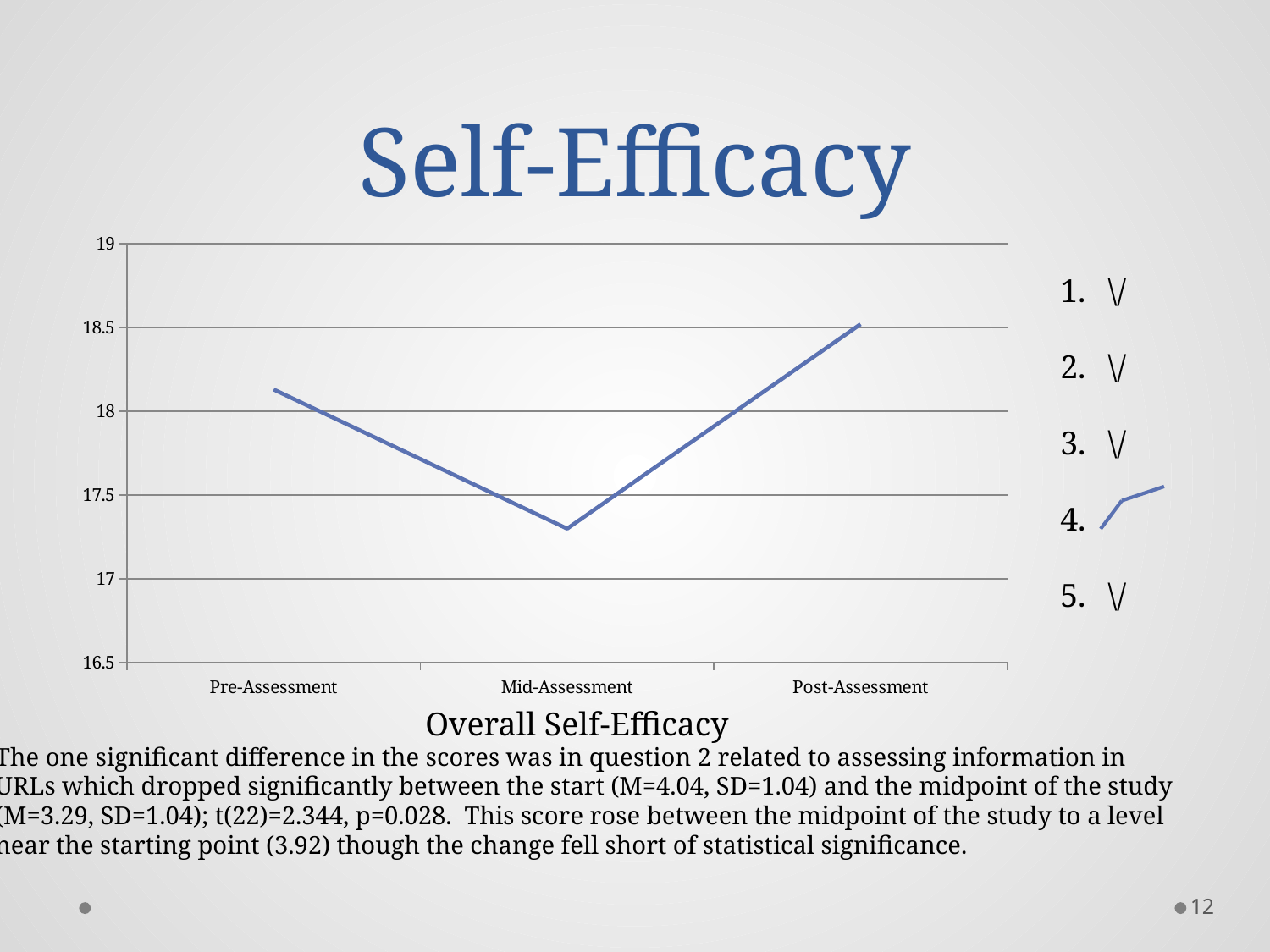
Which assessment has the highest overall self-efficacy value? Post-Assessment How many assessment points are plotted on the chart? 3 Is the value for Post-Assessment greater or less than 18? greater Does the value rise or fall from Pre-Assessment to Mid-Assessment? fall What is the title shown beneath the chart? Overall Self-Efficacy Does the value rise or fall from Mid-Assessment to Post-Assessment? rise Which assessment has the lowest overall self-efficacy value? Mid-Assessment Which is larger, the value for Pre-Assessment or the value for Mid-Assessment? Pre-Assessment Is the value for Pre-Assessment greater or less than 18? greater What kind of chart is shown on the slide? line chart Which is larger, the value for Post-Assessment or the value for Pre-Assessment? Post-Assessment Is the value for Mid-Assessment greater or less than 17.5? less